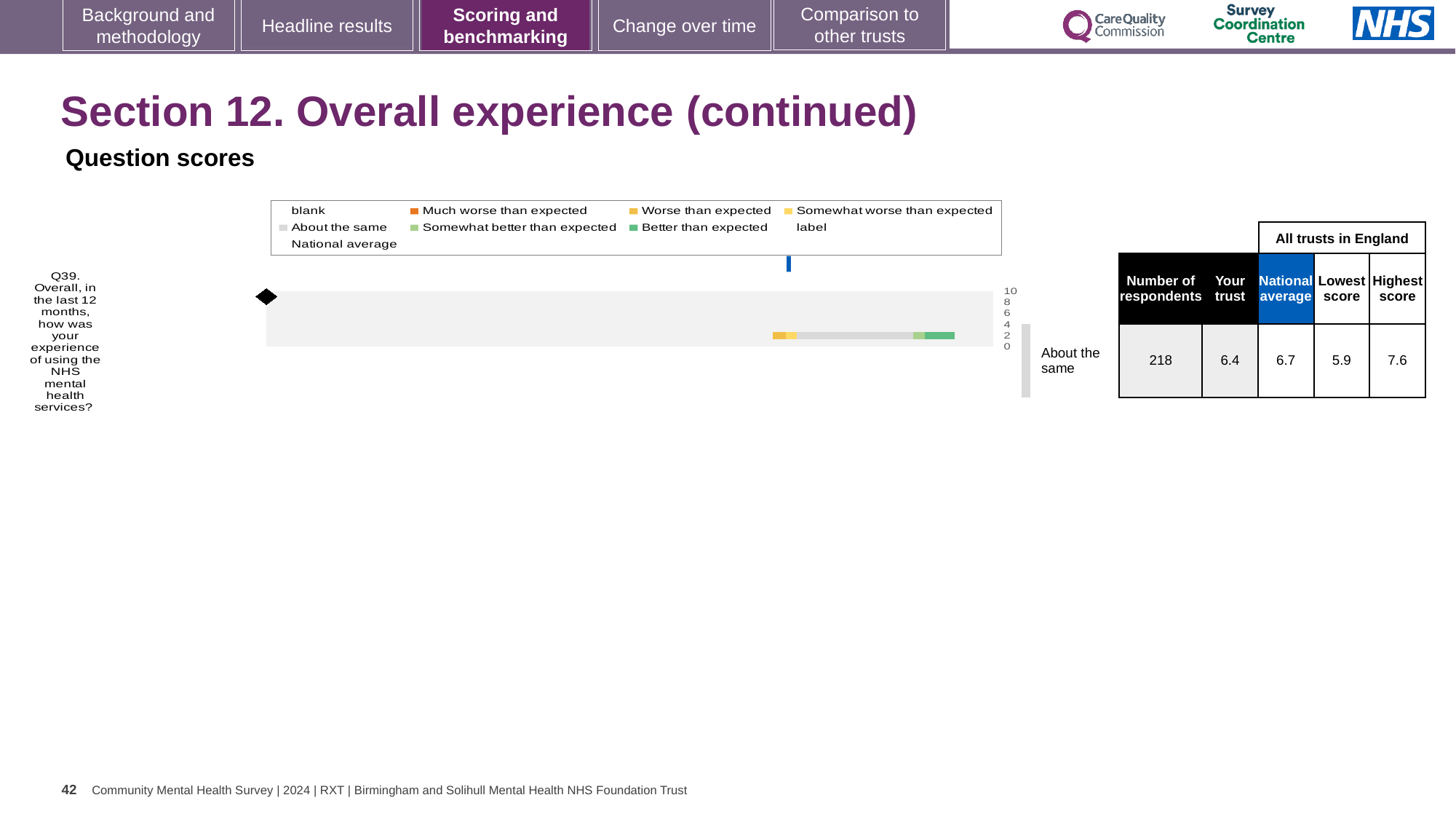
What kind of chart is used to show the Q39 question score? Bar chart What benchmarking category is the trust's Q39 result placed in, according to the label next to the chart? About the same What is the national average score for Q39 shown on the slide? 6.7 How many respondents answered Q39? 218 Which legend entry in the chart is shown in orange? Much worse than expected What is the lowest score among all trusts in England for Q39? 5.9 What is the difference between the national average (6.7) and the 'Your trust' score (6.4) for Q39? 0.3 What is the difference between the highest score (7.6) and the lowest score (5.9) for Q39? 1.7 What is the highest score among all trusts in England for Q39? 7.6 Which is larger for Q39, the 'Your trust' score or the national average? National average What is the 'Your trust' score for Q39 shown on the slide? 6.4 How many survey questions are plotted in the chart on this slide? 1